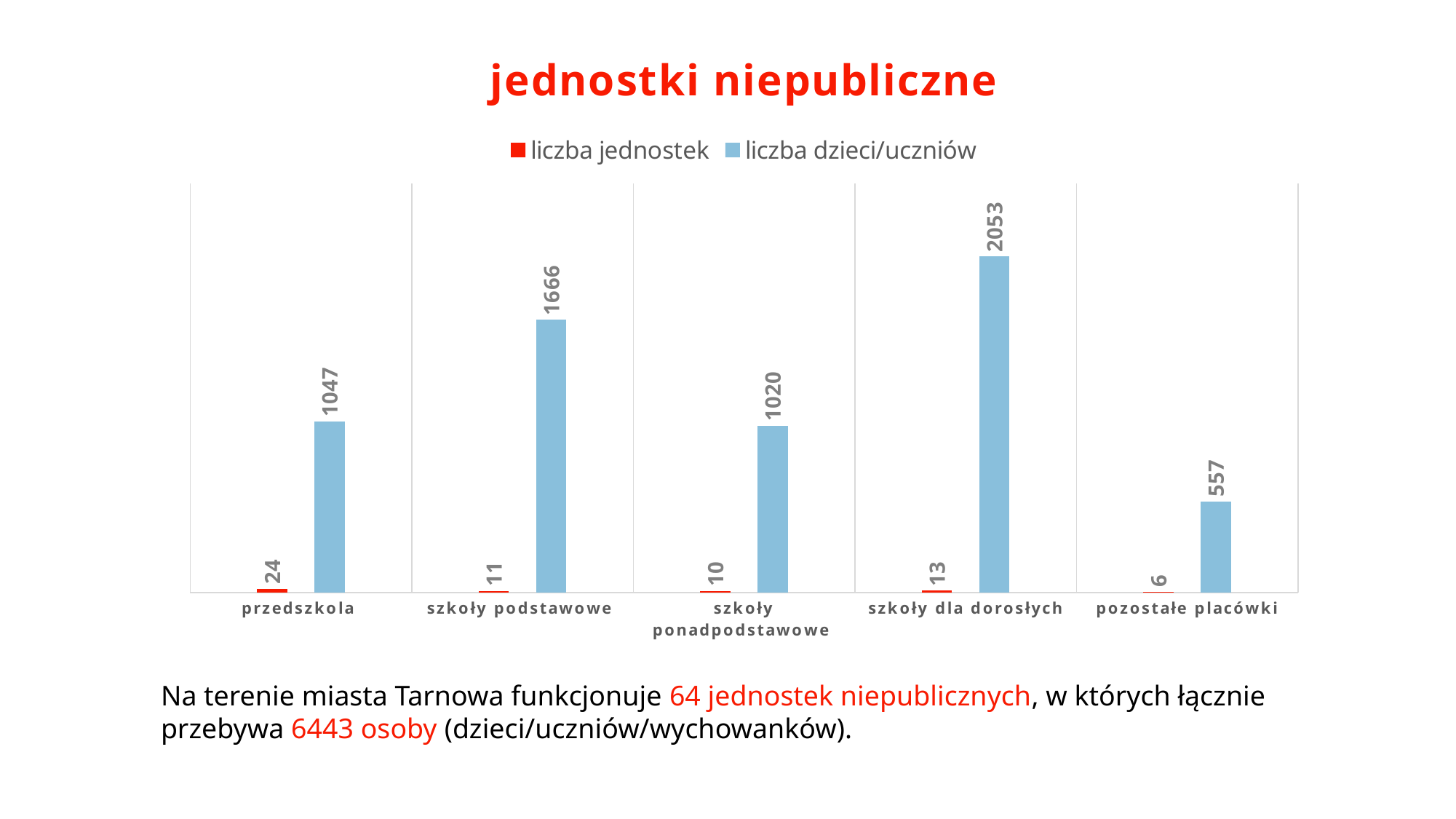
How many series does the legend list? 2 What is the value of 'liczba dzieci/uczniów' for 'pozostałe placówki'? 557 What colour are the bars for the 'liczba jednostek' series? red What kind of chart is shown on the slide? bar chart What is the title of the chart? jednostki niepubliczne Which category has the highest value for 'liczba dzieci/uczniów'? szkoły dla dorosłych How many categories are shown on the x axis? 5 What is the value of 'liczba dzieci/uczniów' for 'szkoły podstawowe'? 1666 Which is larger: 'liczba dzieci/uczniów' for 'przedszkola' or for 'szkoły ponadpodstawowe'? przedszkola What is the difference between 'liczba dzieci/uczniów' for 'szkoły dla dorosłych' and 'szkoły podstawowe'? 387 Which category has the lowest value for 'liczba jednostek'? pozostałe placówki What is the value of 'liczba jednostek' for 'przedszkola'? 24